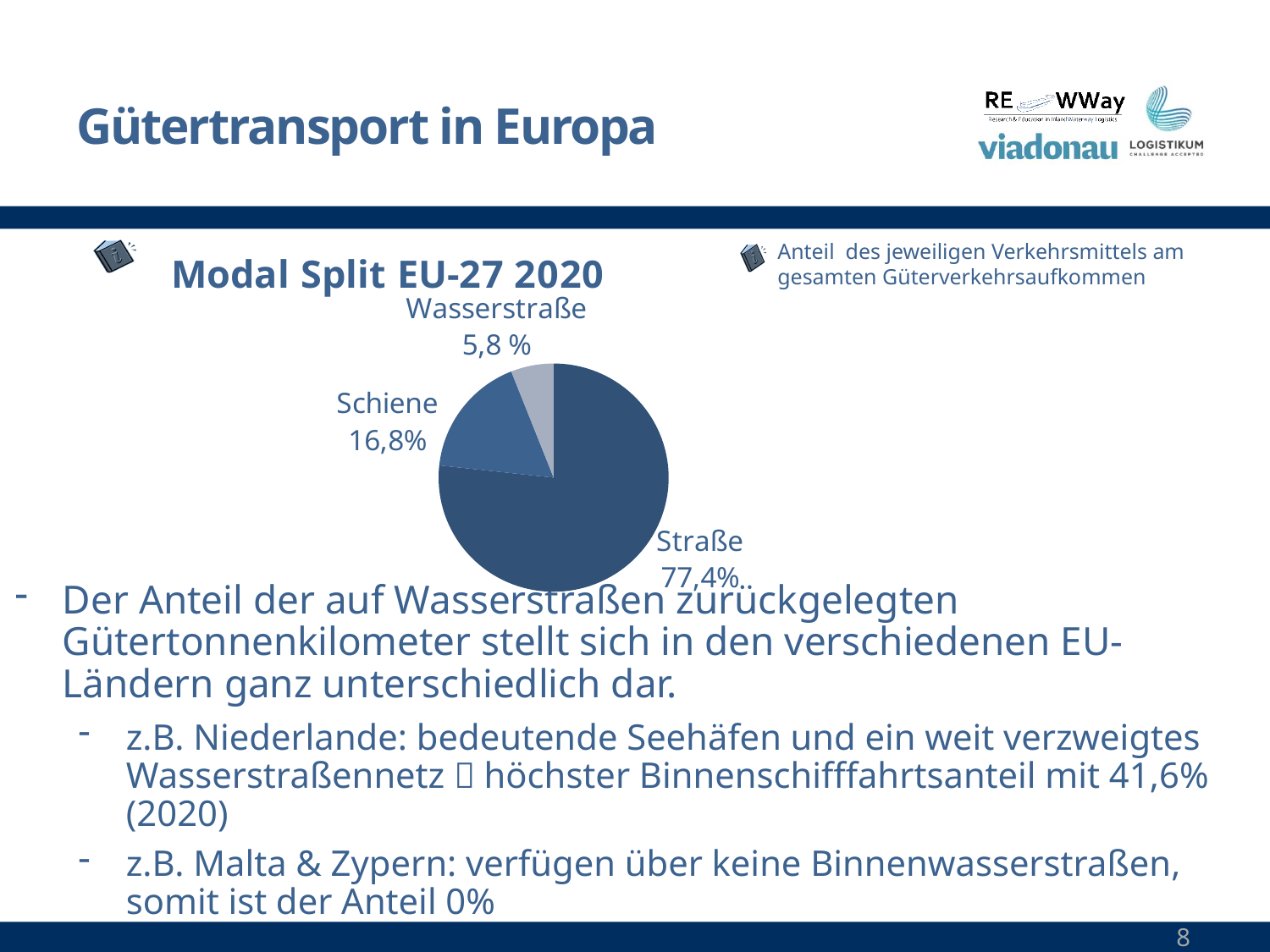
What is the difference in percentage points between the Straße and Schiene slices? 60,6 What share of the pie chart does Schiene account for? 16,8% Which mode of transport has the largest slice in the pie chart? Straße What share of the pie chart does Straße account for? 77,4% What is the title of the chart? Modal Split EU-27 2020 What is the difference in percentage points between the Schiene and Wasserstraße slices? 11,0 Which slice of the pie chart is shown in the lightest grey colour? Wasserstraße What kind of chart is shown on the slide? Pie chart What share of the pie chart does Wasserstraße account for? 5,8 % Which slice is larger, Schiene or Wasserstraße? Schiene How many slices does the pie chart have? 3 Which mode of transport has the smallest slice in the pie chart? Wasserstraße